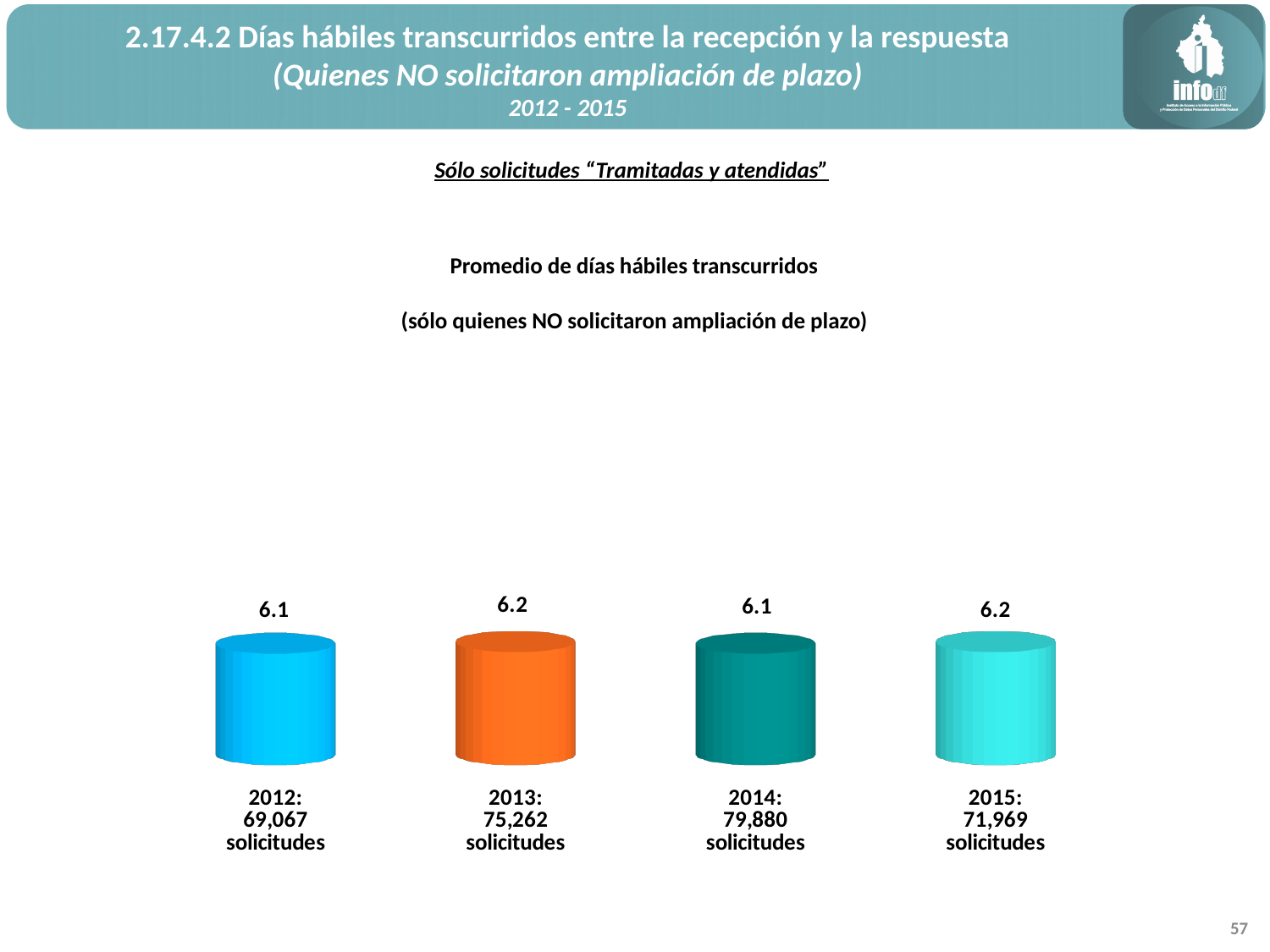
Which has the larger value, 2015 or 2014? 2015 What kind of chart is shown on the slide? Bar chart What is the difference between the values for 2013 and 2012? 0.1 How many years (bars) are shown in the chart? 4 What is the average number of business days shown for 2012? 6.1 What is the title printed above the chart? Promedio de días hábiles transcurridos (sólo quienes NO solicitaron ampliación de plazo) What is the average number of business days shown for 2015? 6.2 How many solicitudes are listed under the 2012 bar? 69,067 solicitudes How many solicitudes are listed under the 2014 bar? 79,880 solicitudes What is the average number of business days shown for 2013? 6.2 What colour is the bar for 2013? Orange What is the average number of business days shown for 2014? 6.1